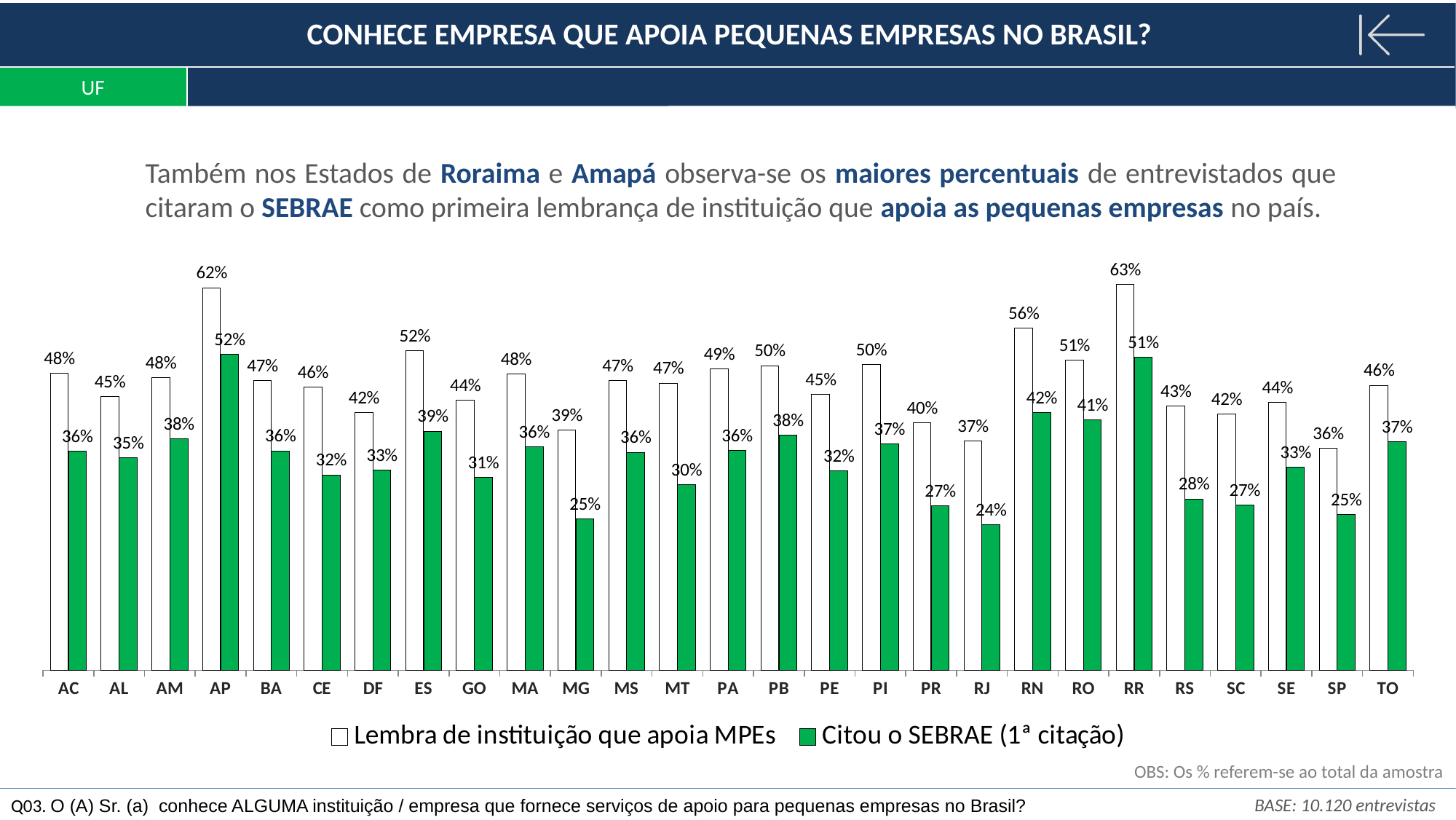
Which state has the highest value for "Lembra de instituição que apoia MPEs"? RR Which state has the lowest value for "Citou o SEBRAE (1ª citação)"? RJ What is the value of "Citou o SEBRAE (1ª citação)" for AP? 52% What kind of chart is shown on the slide? Bar chart Which is larger: "Citou o SEBRAE (1ª citação)" for RO or for RS? RO How many states (UF) are shown on the x axis? 27 What is the difference between the two series for RN? 14% How many series does the legend list? 2 Which state has the lowest value for "Lembra de instituição que apoia MPEs"? SP What is the value of "Citou o SEBRAE (1ª citação)" for MG? 25% What is the value of "Lembra de instituição que apoia MPEs" for RR? 63% What colour are the bars for "Citou o SEBRAE (1ª citação)"? Green